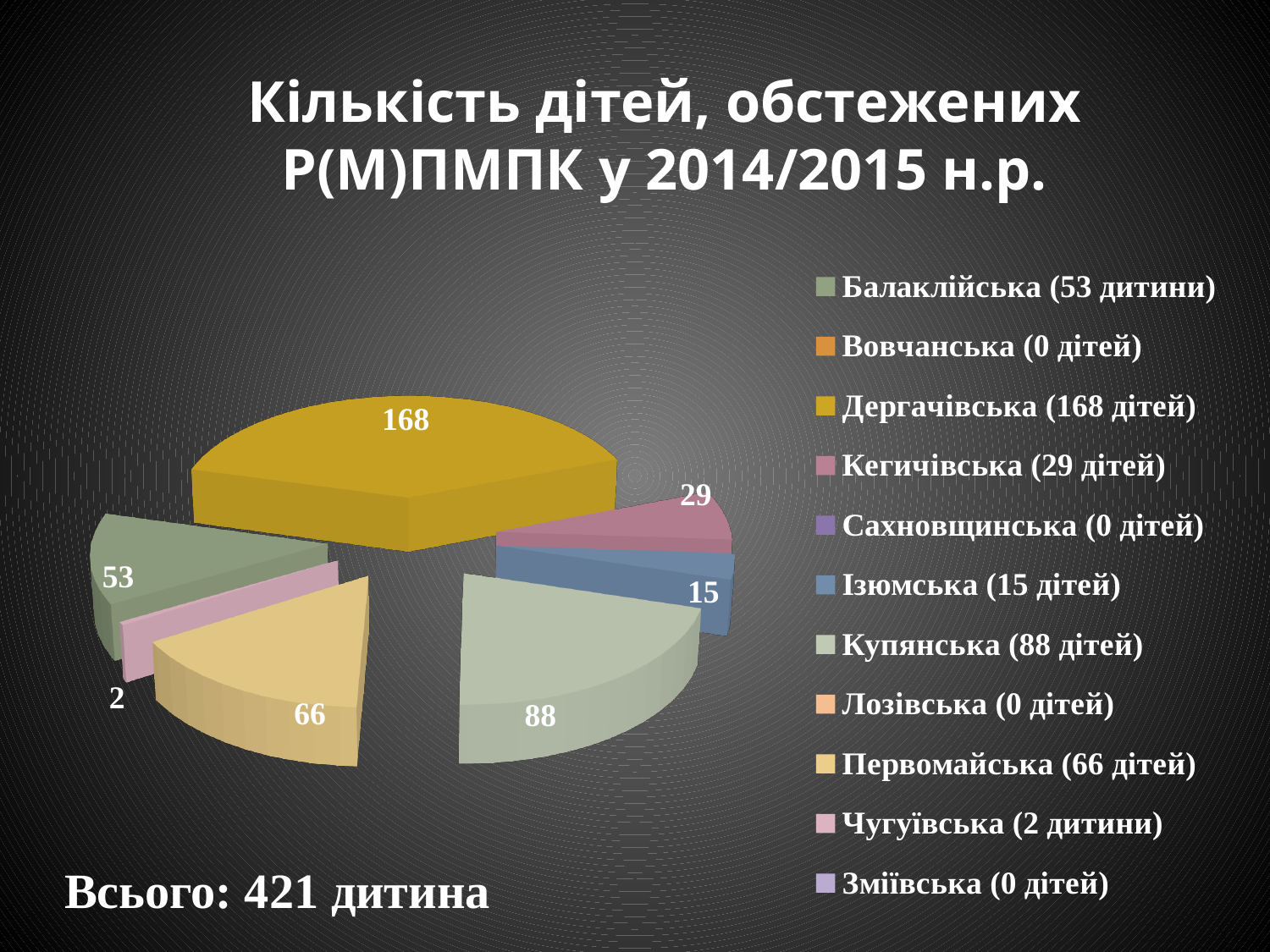
What total number of children is stated on the slide? 421 Which is larger, the value for Первомайська or the value for Балаклійська? Первомайська What is the value shown for Ізюмська? 15 Which district with a non-zero value has the smallest slice? Чугуївська Which district has the largest slice of the pie? Дергачівська How many districts in the legend have a value of 0? 4 What is the value shown for Чугуївська? 2 How many districts are listed in the legend? 11 How many children does the slice for Дергачівська represent? 168 What kind of chart is shown on the slide? pie chart What is the difference between the values for Дергачівська and Купянська? 80 What is the value shown for Купянська? 88